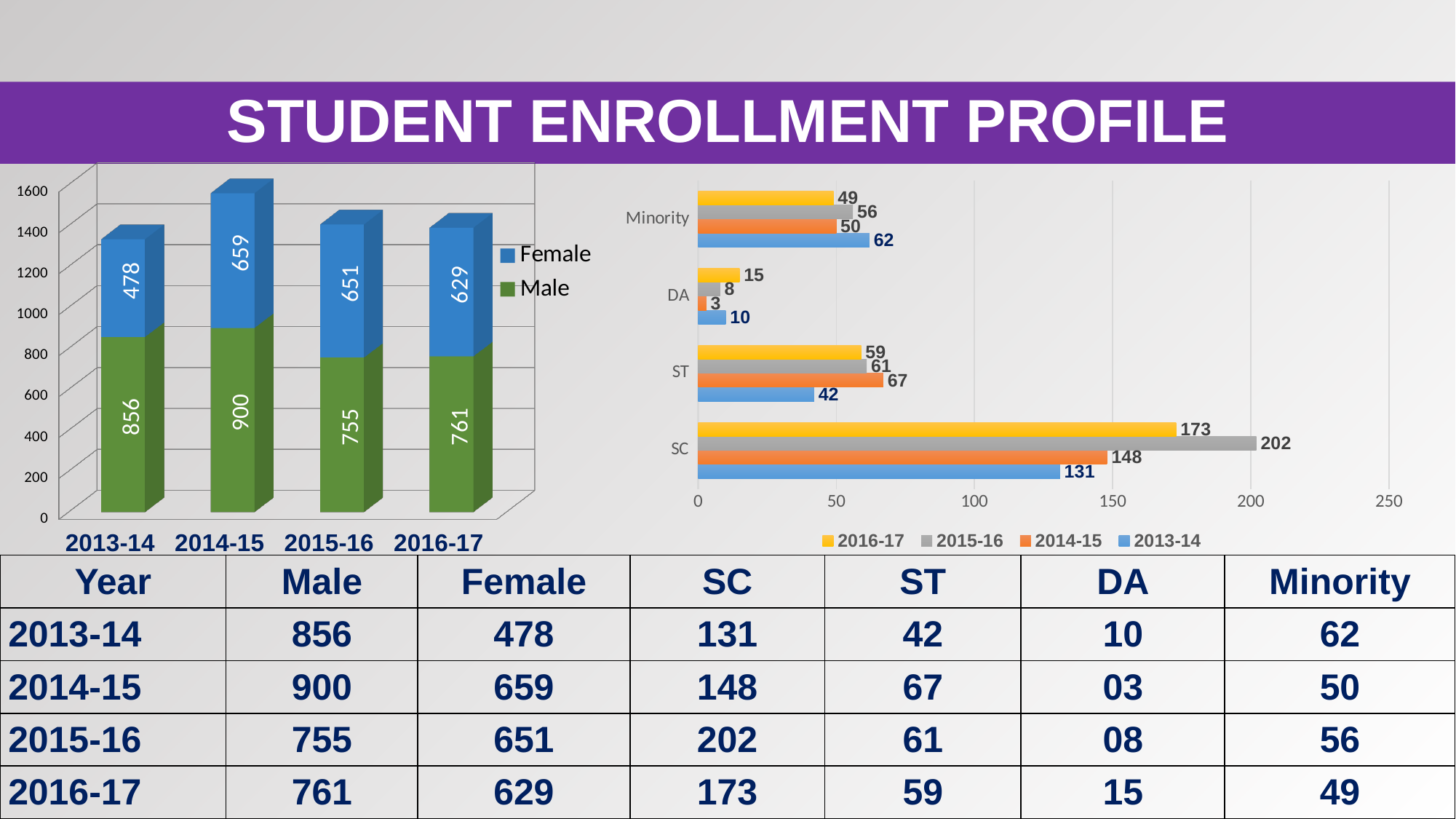
In the right horizontal bar chart, what is the difference between the SC values for 2016-17 and 2013-14? 42 In the right horizontal bar chart, how many categories are shown on the vertical axis? 4 In the left stacked bar chart, what is the total of the stacked bar for 2013-14? 1334 In the left stacked bar chart, how many series does the legend list? 2 In the left stacked bar chart, what is the Male value for 2014-15? 900 In the left stacked bar chart, what is the Female value for 2016-17? 629 What kind of chart is the chart on the right of the slide? Bar chart In the right horizontal bar chart, which is larger: the Minority value for 2013-14 or for 2016-17? 2013-14 In the left stacked bar chart, which year has the highest Female value? 2014-15 In the left stacked bar chart, which year has the lowest Male value? 2015-16 In the right horizontal bar chart, what is the SC value for 2015-16? 202 In the right horizontal bar chart, what is the DA value for 2014-15? 3